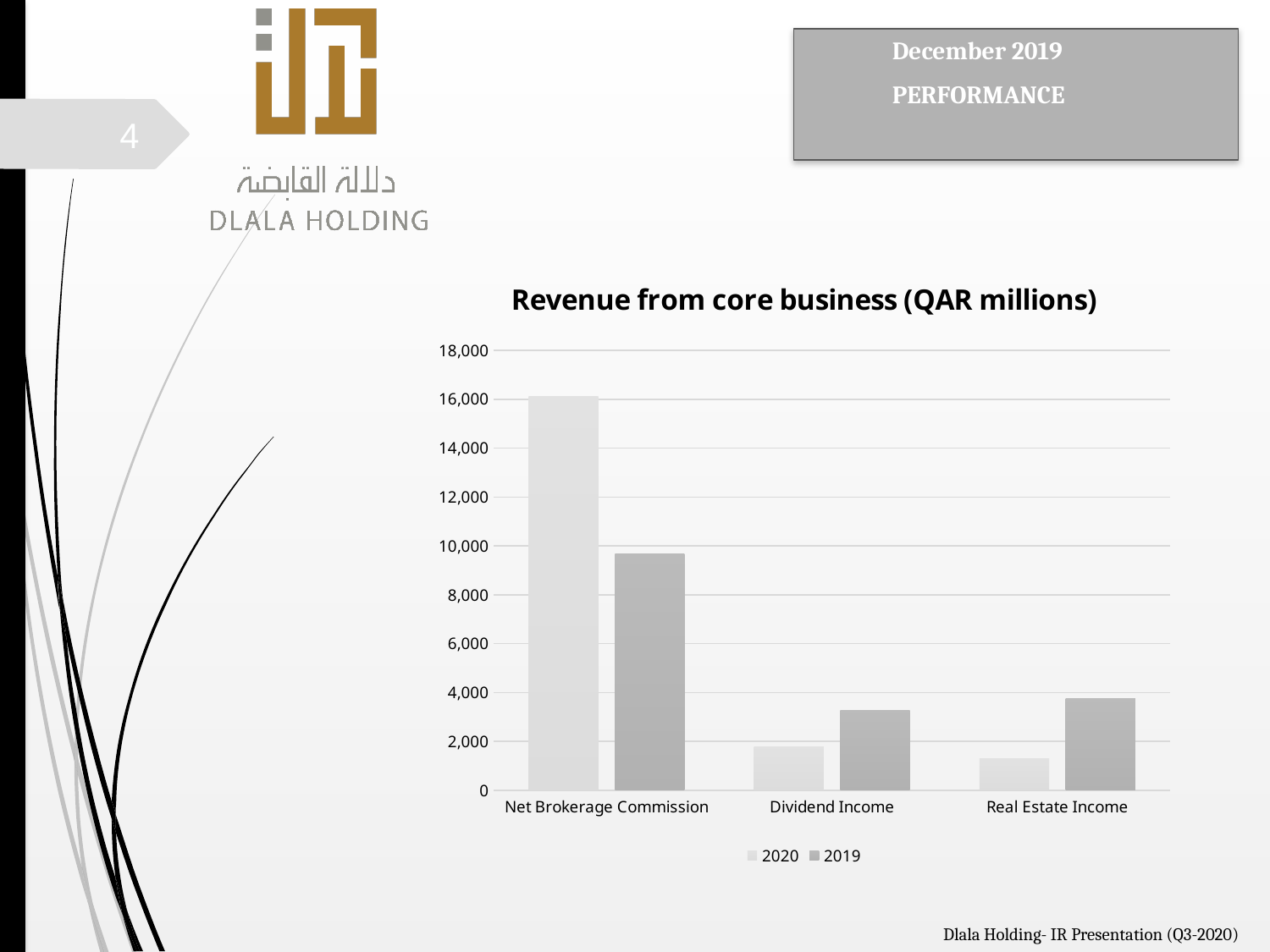
What kind of chart is shown on the slide? Bar chart What is the title of the chart? Revenue from core business (QAR millions) Is the 2020 value for Real Estate Income greater or less than 2,000? less Is the 2020 value for Net Brokerage Commission greater or less than 14,000? greater Which category has the lowest 2020 value? Real Estate Income How many series does the chart legend list? 2 Which category has the lowest 2019 value? Dividend Income How many categories are shown on the x axis of the chart? 3 Which category has the highest 2020 value? Net Brokerage Commission Which series are listed in the chart legend? 2020 and 2019 For Net Brokerage Commission, which year has the larger value, 2020 or 2019? 2020 For Dividend Income, which year has the larger value, 2020 or 2019? 2019